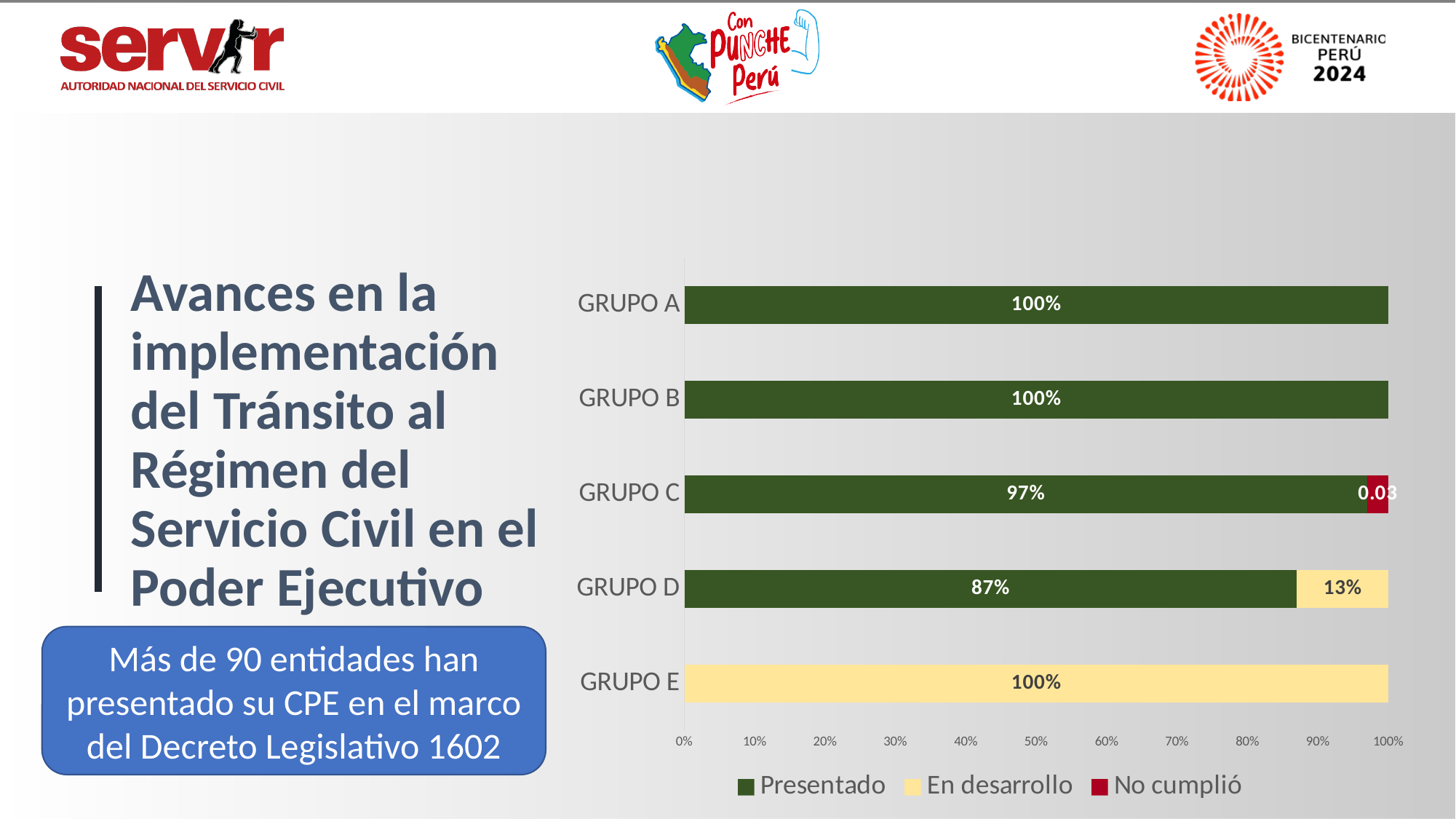
Which series is shown in red in the legend? No cumplió Which is larger, the Presentado value for GRUPO B or for GRUPO D? GRUPO B What is the En desarrollo value for GRUPO D? 13% How many groups (categories) are plotted on the chart? 5 What is the En desarrollo value for GRUPO E? 100% What is the Presentado value for GRUPO C? 97% What is the difference between the Presentado values of GRUPO C and GRUPO D? 10% Which group has the lowest Presentado value among groups A to D? GRUPO D What is the No cumplió value shown for GRUPO C? 0.03 What is the Presentado value for GRUPO D? 87% How many series does the chart legend list? 3 What kind of chart is shown on the slide? bar chart